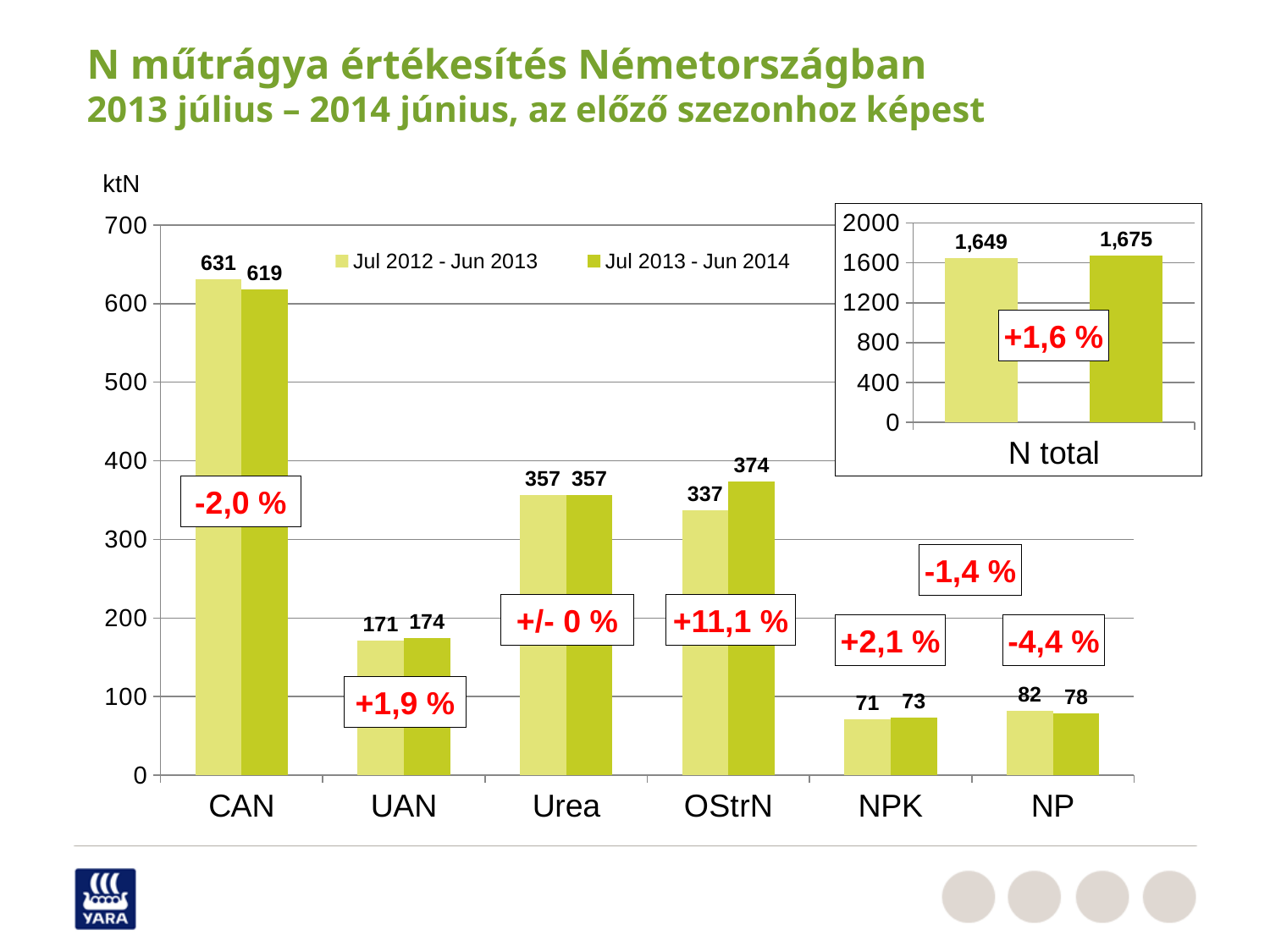
What unit is shown above the y axis of the main chart? ktN In the inset N total chart, what is the value for Jul 2013 - Jun 2014? 1,675 In the main chart, which is larger for NP: the Jul 2012 - Jun 2013 value or the Jul 2013 - Jun 2014 value? Jul 2012 - Jun 2013 In the main chart, which category has the lowest value in the Jul 2012 - Jun 2013 series? NPK How many series does the legend of the main chart list? 2 What kind of chart is the main chart? bar chart In the main chart, which category has the highest value in the Jul 2013 - Jun 2014 series? CAN In the main chart, what is the value for OStrN in the Jul 2012 - Jun 2013 series? 337 In the main chart, what is the difference between the Jul 2013 - Jun 2014 and Jul 2012 - Jun 2013 values for OStrN? 37 In the inset N total chart, what is the difference between the Jul 2013 - Jun 2014 and Jul 2012 - Jun 2013 values? 26 How many categories are shown on the x axis of the main chart? 6 In the main chart, what is the value for CAN in the Jul 2013 - Jun 2014 series? 619